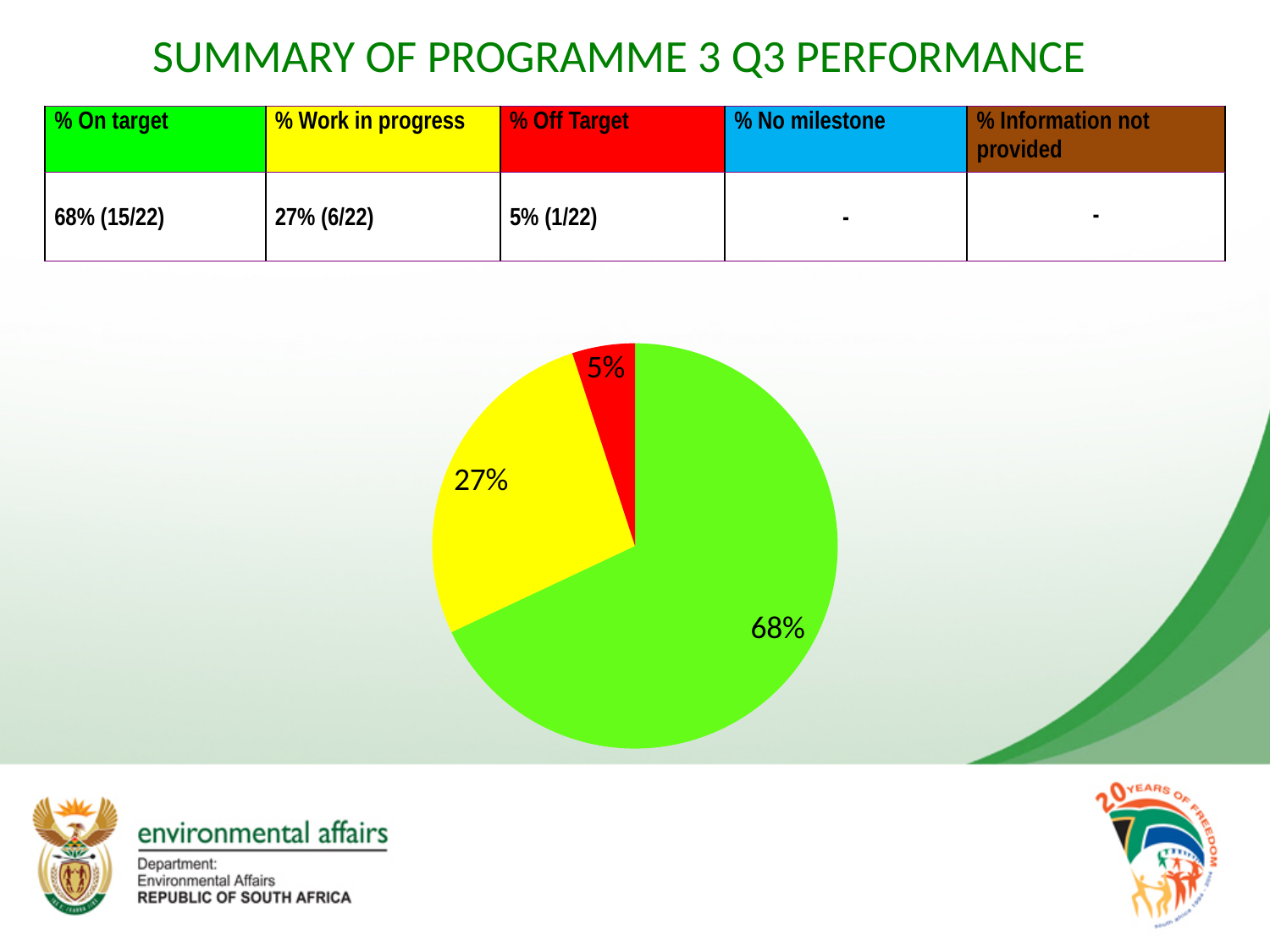
What percentage is shown on the red slice of the pie chart? 5% What percentage is shown on the green slice of the pie chart? 68% How many slices does the pie chart have? 3 What is the difference between the green slice and the yellow slice of the pie chart? 41% What percentage is shown on the yellow slice of the pie chart? 27% What is the difference between the yellow slice and the red slice of the pie chart? 22% Which slice of the pie chart is the largest? 68% (green, On target) What share of the pie does the On target (green) slice represent? 68% What kind of chart is shown on the slide? pie chart Which is larger in the pie chart, the yellow slice or the red slice? the yellow slice (27%) Which slice of the pie chart is the smallest? 5% (red, Off Target) What colour is the slice representing Work in progress in the pie chart? yellow